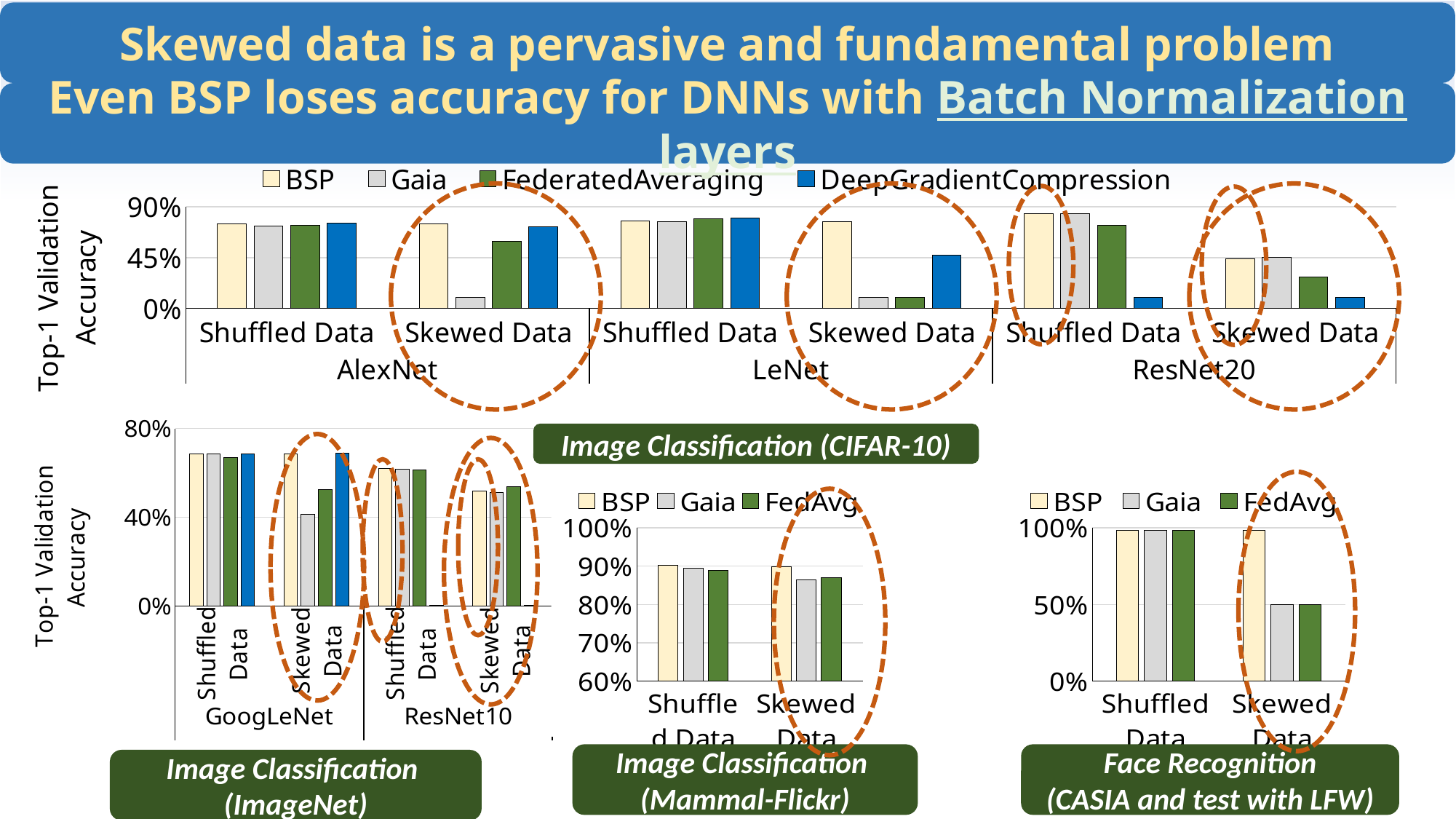
In the Face Recognition (CASIA and test with LFW) chart, which is larger for Skewed Data: BSP or FedAvg? BSP In the Image Classification (CIFAR-10) chart at the top, is the value for DeepGradientCompression on ResNet20 Shuffled Data greater or less than 45%? less In the Face Recognition (CASIA and test with LFW) chart, how many categories are shown on the x axis? 2 In the Image Classification (CIFAR-10) chart at the top, which series has the highest value for LeNet Skewed Data? BSP In the Image Classification (ImageNet) chart at the bottom left, is the value for FederatedAveraging on GoogLeNet Skewed Data greater or less than 40%? greater In the Image Classification (CIFAR-10) chart at the top, is the value for Gaia on LeNet Skewed Data greater or less than 45%? less In the Image Classification (CIFAR-10) chart at the top, how many series does the legend list? 4 In the Image Classification (CIFAR-10) chart at the top, which is larger for AlexNet Skewed Data: FederatedAveraging or Gaia? FederatedAveraging What kind of chart is the Face Recognition (CASIA and test with LFW) chart? bar chart In the Image Classification (Mammal-Flickr) chart, how many series does the legend list? 3